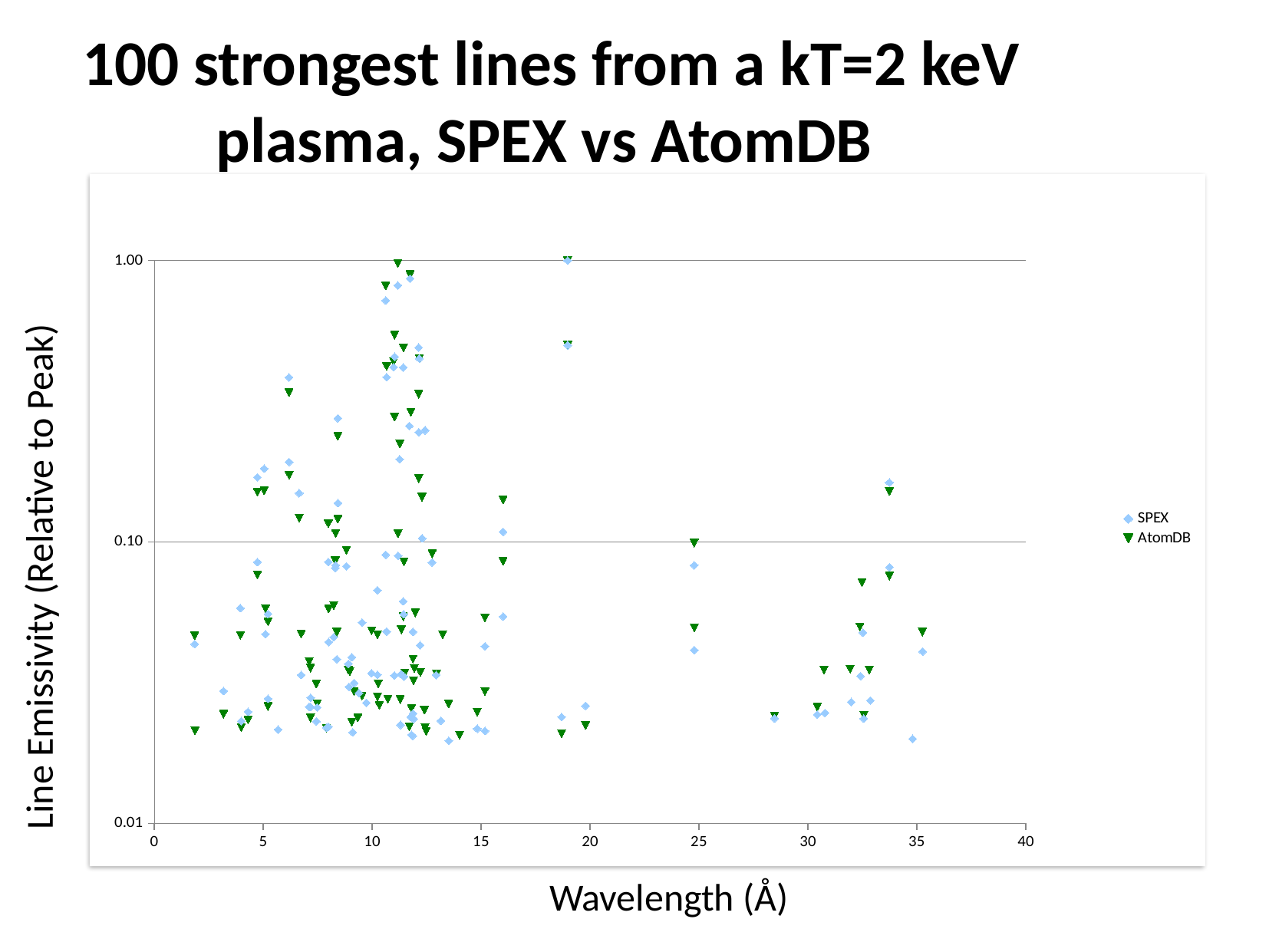
Is the highest plotted point between 30 and 35 Å greater or less than 0.10? greater Are any points plotted between 20 and 24 Å on the x axis? no What are the two series named in the legend? SPEX and AtomDB Is the highest SPEX point near 25 Å greater or less than 0.10? less Which series is plotted with green triangle markers? AtomDB What kind of chart is shown on the slide? scatter chart Is the lowest plotted value on the chart greater or less than 0.01? greater How many series does the legend list? 2